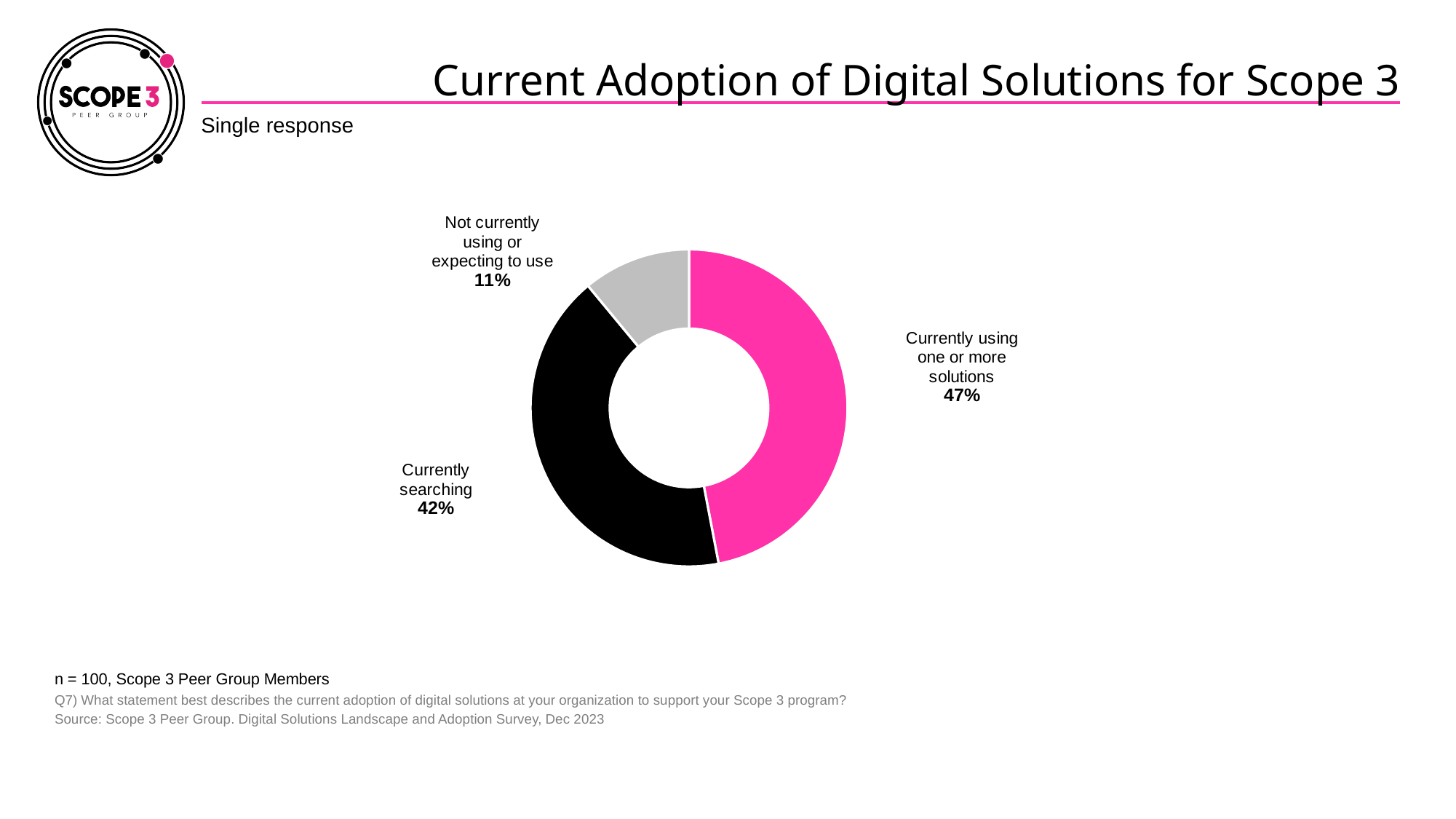
What is the difference in percentage points between 'Currently using one or more solutions' and 'Currently searching'? 5 What colour is the slice for 'Currently searching'? Black What percentage of respondents are currently searching? 42% What percentage of respondents are currently using one or more solutions? 47% What is the title of the chart on the slide? Current Adoption of Digital Solutions for Scope 3 Which is larger: the share for 'Currently searching' or the share for 'Not currently using or expecting to use'? Currently searching How many categories are shown in the chart? 3 What kind of chart is shown on the slide? Doughnut chart Which category has the smallest share of the chart? Not currently using or expecting to use Which category has the largest share of the chart? Currently using one or more solutions What percentage of respondents are not currently using or expecting to use digital solutions? 11% What is the difference in percentage points between 'Currently searching' and 'Not currently using or expecting to use'? 31